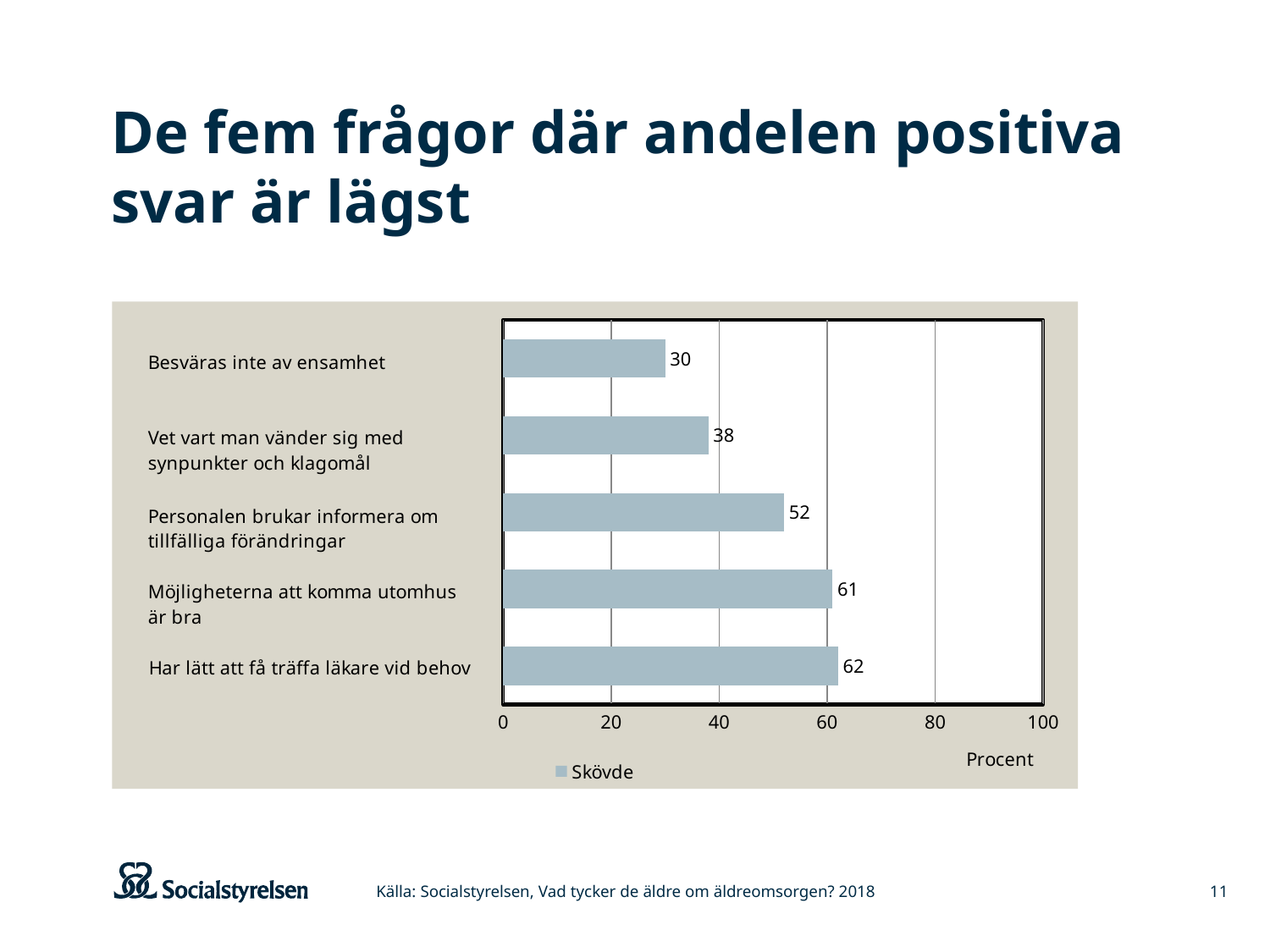
Which category has the highest value? Har lätt att få träffa läkare vid behov What is the value for "Personalen brukar informera om tillfälliga förändringar"? 52 How many categories are shown in the chart? 5 Is the value for "Vet vart man vänder sig med synpunkter och klagomål" greater or less than 40? less What kind of chart is shown on the slide? bar chart Which category has the lowest value? Besväras inte av ensamhet What is the value for "Besväras inte av ensamhet"? 30 Which is larger: the value for "Möjligheterna att komma utomhus är bra" or the value for "Vet vart man vänder sig med synpunkter och klagomål"? Möjligheterna att komma utomhus är bra What is the name of the series shown in the legend? Skövde What is the difference between the values for "Personalen brukar informera om tillfälliga förändringar" and "Vet vart man vänder sig med synpunkter och klagomål"? 14 What is the value for "Har lätt att få träffa läkare vid behov"? 62 How many series does the legend list? 1